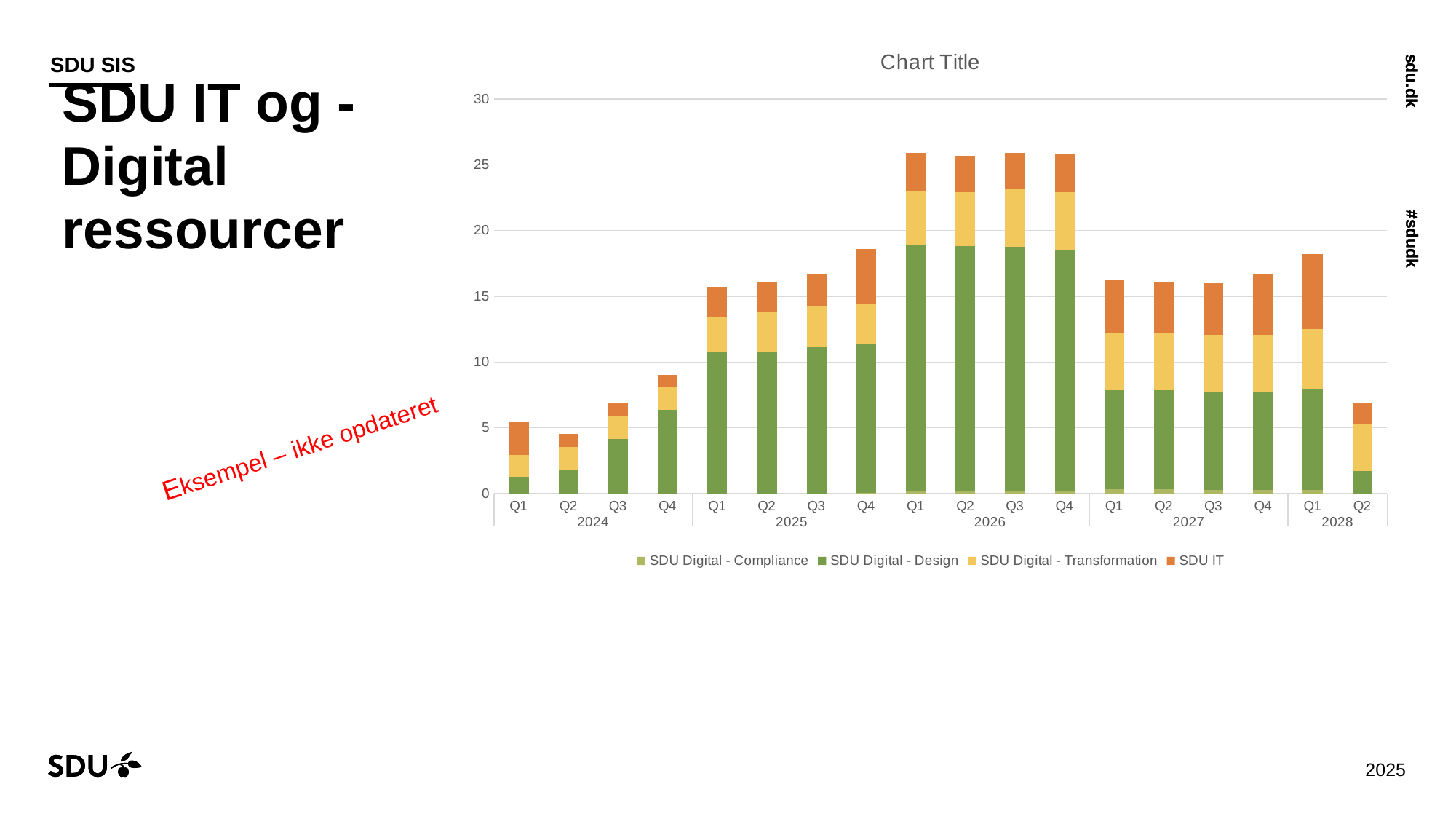
Is the total stacked value for Q2 2024 greater or less than 5? less Across the four quarters of 2025, do the total bar heights rise or fall from Q1 to Q4? rise Is the total stacked value for Q1 2028 greater or less than 15? greater What is the title shown above the chart? Chart Title Is the total stacked value for Q1 2026 greater or less than 25? greater How many quarterly bars are plotted in the chart? 18 How many series does the chart legend list? 4 Which series is shown in orange in the chart legend? SDU IT What kind of chart is shown on the slide? Stacked bar chart Which has the taller total bar, Q1 2026 or Q1 2027? Q1 2026